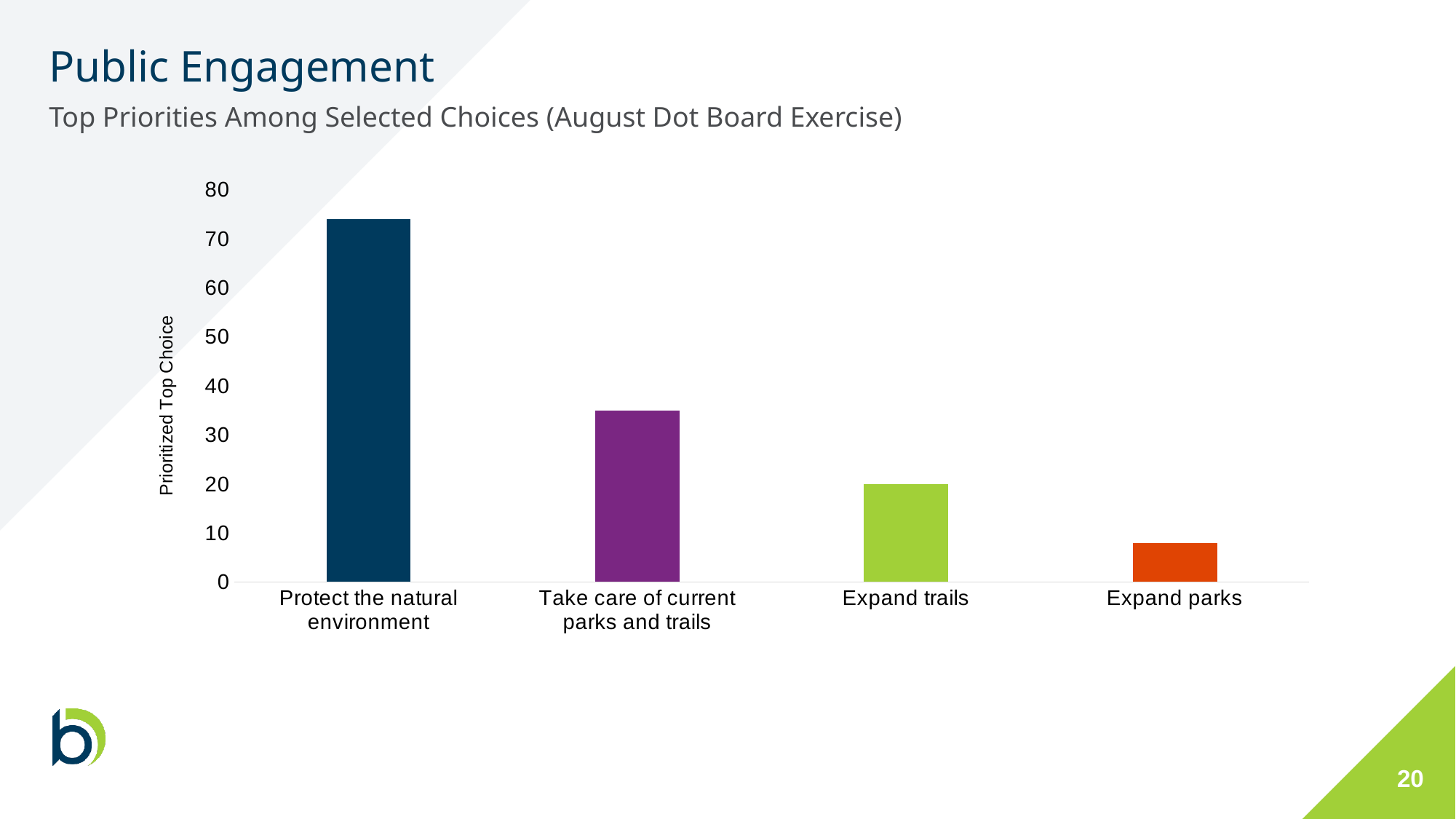
What is the value for Expand trails? 20 Which is larger, the value for Take care of current parks and trails or the value for Expand trails? Take care of current parks and trails What kind of chart is shown on the slide? bar chart Which category has the lowest value? Expand parks Is the value for Protect the natural environment greater or less than 70? greater Is the value for Take care of current parks and trails greater or less than 30? greater How many categories are shown on the x axis of the chart? 4 Is the value for Expand parks greater or less than 10? less Which category has the highest value? Protect the natural environment Do the values rise or fall moving from left to right along the x axis? fall What is the label on the y axis of the chart? Prioritized Top Choice What is the subtitle describing the chart on the slide? Top Priorities Among Selected Choices (August Dot Board Exercise)